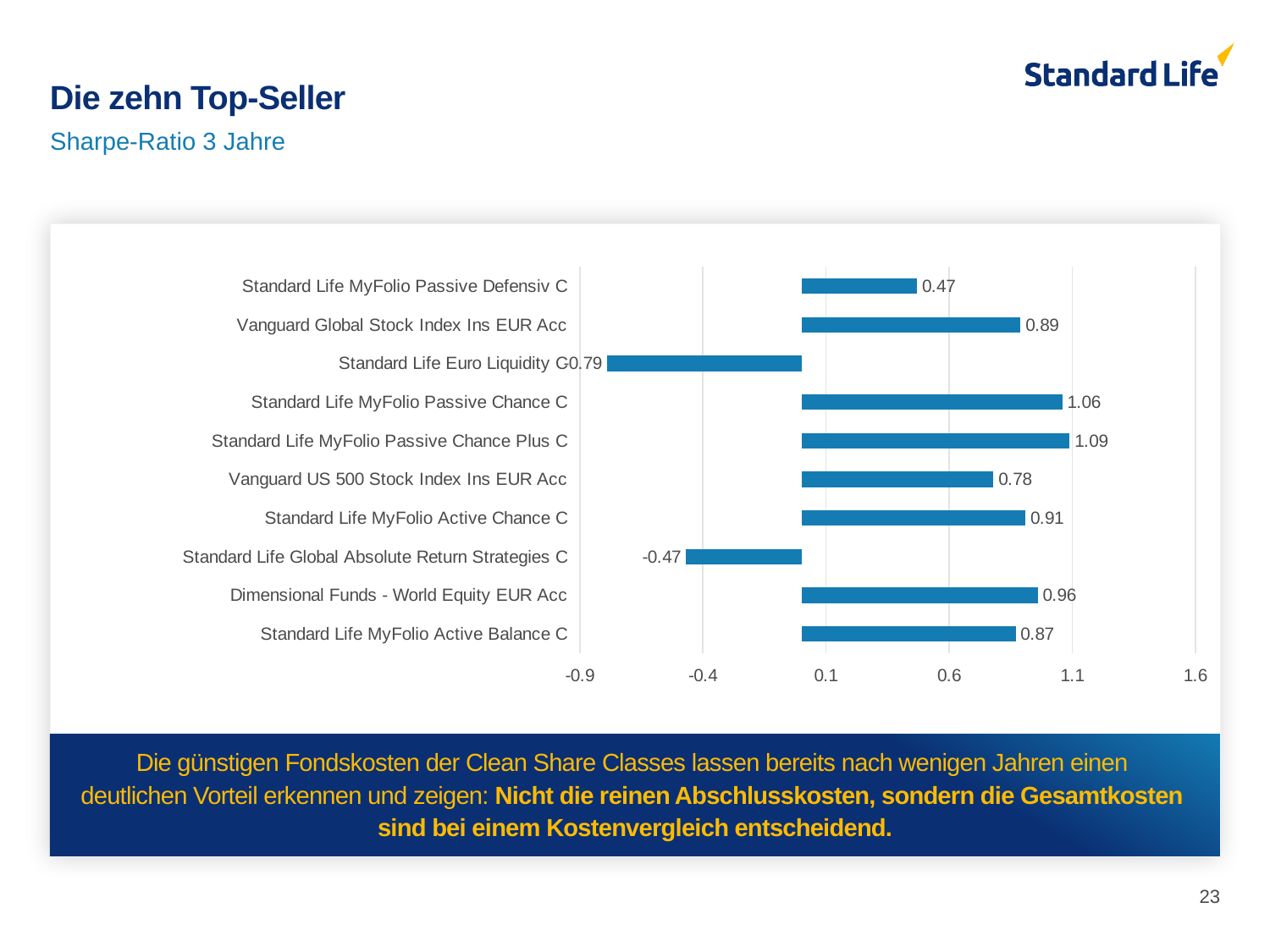
What kind of chart is shown on the slide? bar chart Which has the larger value: Standard Life MyFolio Active Chance C or Standard Life MyFolio Active Balance C? Standard Life MyFolio Active Chance C What is the Sharpe ratio shown for Standard Life MyFolio Passive Defensiv C? 0.47 How many funds are shown in the chart? 10 Which fund has the highest Sharpe ratio in the chart? Standard Life MyFolio Passive Chance Plus C What is the difference between the values for Vanguard Global Stock Index Ins EUR Acc and Vanguard US 500 Stock Index Ins EUR Acc? 0.11 Which fund has the lowest Sharpe ratio in the chart? Standard Life Euro Liquidity C What value is shown for Dimensional Funds - World Equity EUR Acc? 0.96 What value is shown for Vanguard US 500 Stock Index Ins EUR Acc? 0.78 Is the value for Standard Life Euro Liquidity C greater or less than -0.4? less What value is shown for Standard Life Global Absolute Return Strategies C? -0.47 What is the difference between the values for Standard Life MyFolio Passive Chance Plus C and Standard Life MyFolio Passive Chance C? 0.03